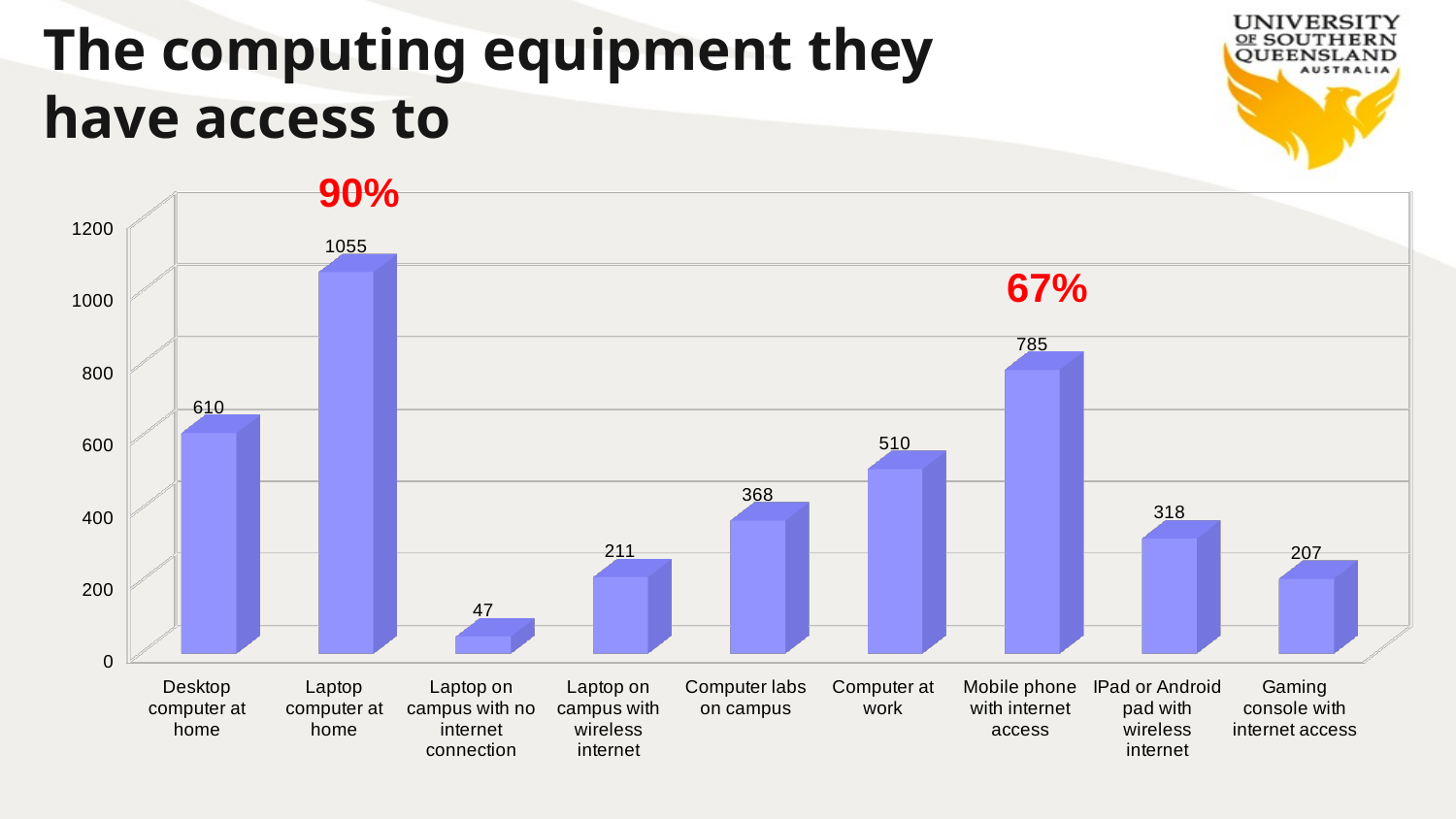
What is the difference between the values for Computer at work and Computer labs on campus? 142 What is the value for Laptop computer at home? 1055 What is the value for Laptop on campus with no internet connection? 47 Which category has the lowest value? Laptop on campus with no internet connection What percentage is annotated in red above the Mobile phone with internet access bar? 67% What is the value for Mobile phone with internet access? 785 Which category has the highest value? Laptop computer at home Is the value for Computer at work greater or less than 400? greater What kind of chart is shown on the slide? bar chart How many categories are shown on the chart? 9 What is the difference between the values for Laptop computer at home and Desktop computer at home? 445 Which is larger, the value for IPad or Android pad with wireless internet or the value for Gaming console with internet access? IPad or Android pad with wireless internet